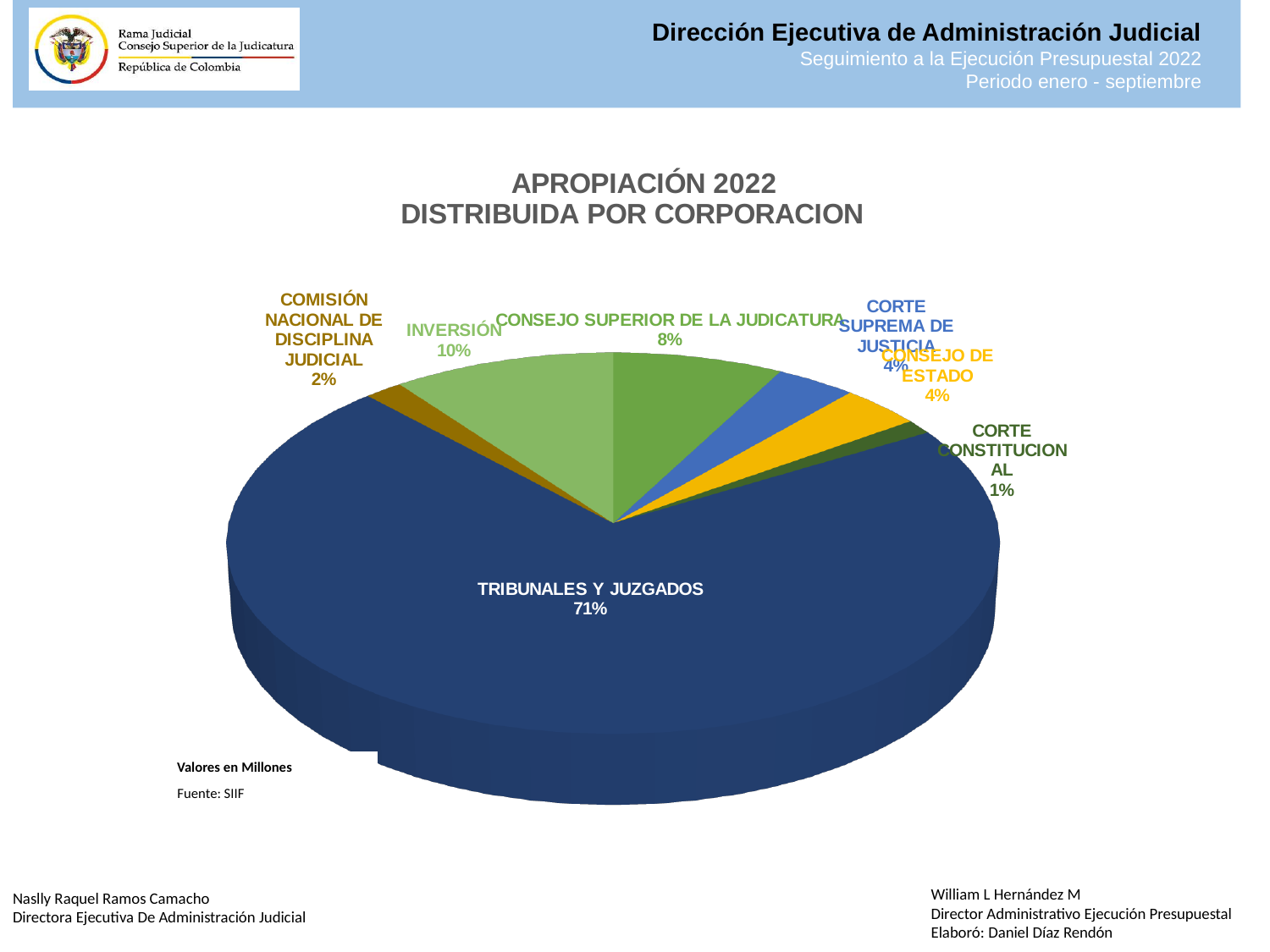
What percentage is shown for COMISIÓN NACIONAL DE DISCIPLINA JUDICIAL? 2% What kind of chart is shown on the slide? Pie chart Which category has the smallest share of the pie? CORTE CONSTITUCIONAL How many slices does the pie chart have? 7 What is the difference in percentage points between TRIBUNALES Y JUZGADOS and INVERSIÓN? 61 What percentage is shown for INVERSIÓN? 10% What is the title of the chart? APROPIACIÓN 2022 DISTRIBUIDA POR CORPORACION Which has a larger share, INVERSIÓN or CONSEJO SUPERIOR DE LA JUDICATURA? INVERSIÓN Which category has the largest share of the pie? TRIBUNALES Y JUZGADOS What percentage is shown for CONSEJO SUPERIOR DE LA JUDICATURA? 8% What share of the pie does TRIBUNALES Y JUZGADOS represent? 71% What percentage is shown for CORTE CONSTITUCIONAL? 1%